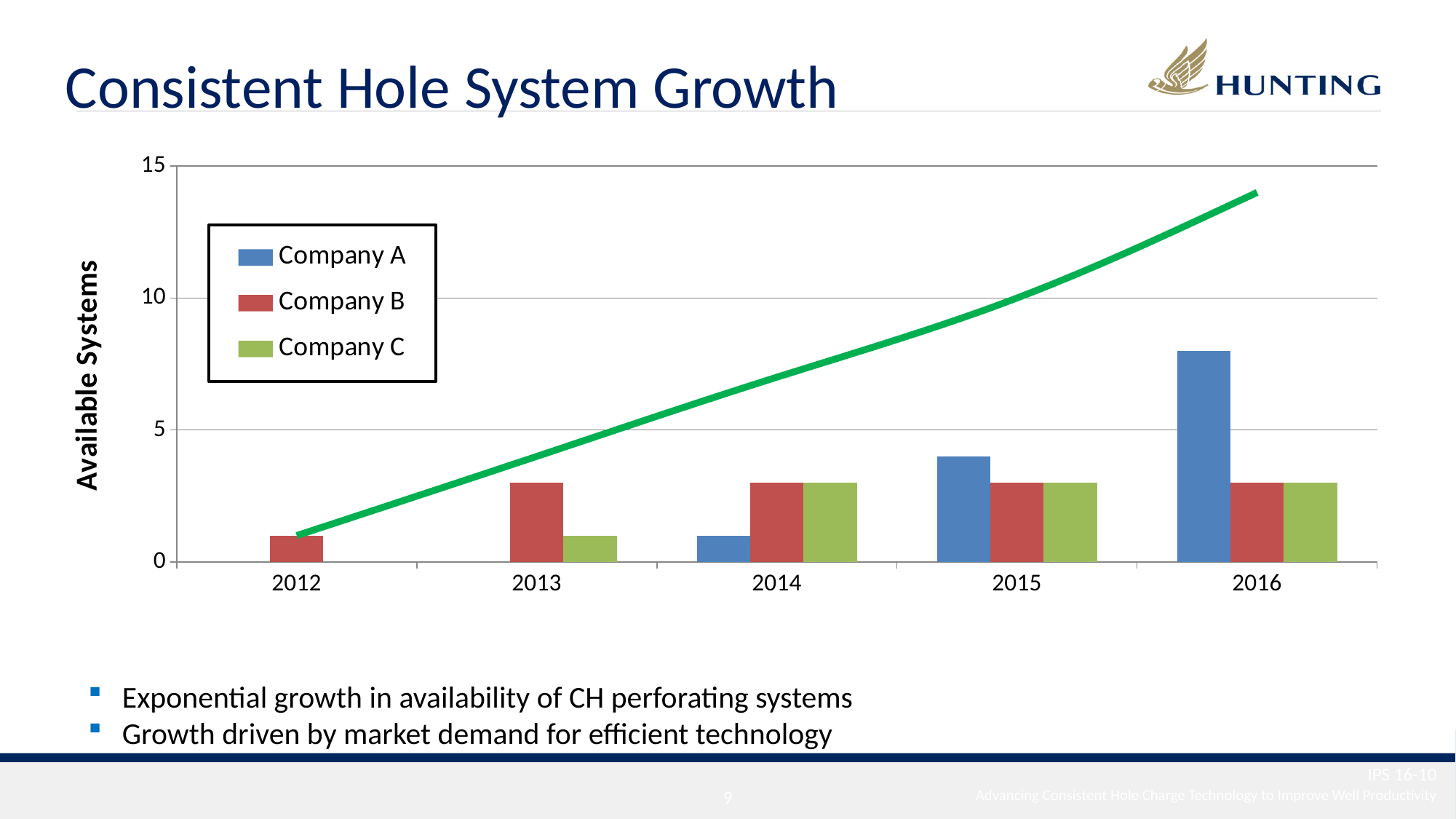
How many years are shown on the x axis? 5 Is the value for Company A in 2016 greater or less than 5? greater What colour is the trend line drawn over the bars? green Which year has the tallest bar for Company A? 2016 Is the value for Company B in 2015 greater or less than 5? less In 2013, which is larger: the value for Company B or the value for Company C? Company B What is the label on the y axis? Available Systems How many series does the legend list? 3 What kind of chart is shown on the slide? combination bar and line chart In 2016, which is larger: the value for Company A or the value for Company B? Company A Do the values for Company A rise or fall from 2014 to 2016? rise Is the value for Company A in 2016 greater or less than 10? less